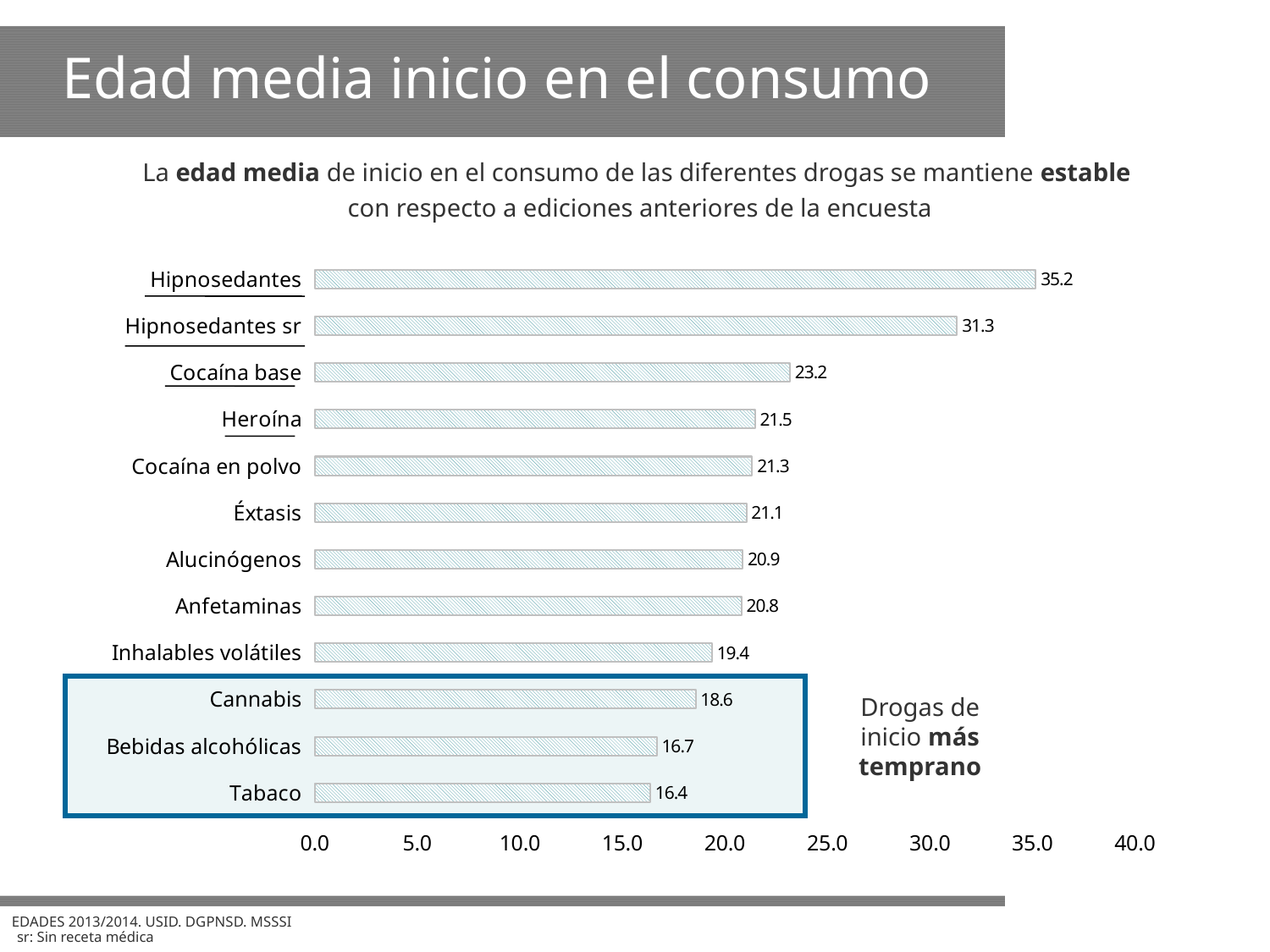
What kind of chart is shown on the slide? bar chart What is the difference between the values for Cannabis and Tabaco? 2.2 What is the value for Heroína? 21.5 What is the title of the slide? Edad media inicio en el consumo What is the value for Hipnosedantes? 35.2 Which category has the highest value? Hipnosedantes Which is larger, the value for Cocaína base or the value for Inhalables volátiles? Cocaína base Which category has the lowest value? Tabaco What is the value for Cannabis? 18.6 How many categories are shown in the chart? 12 What is the difference between the values for Hipnosedantes and Hipnosedantes sr? 3.9 Is the value for Bebidas alcohólicas greater or less than 20.0? less